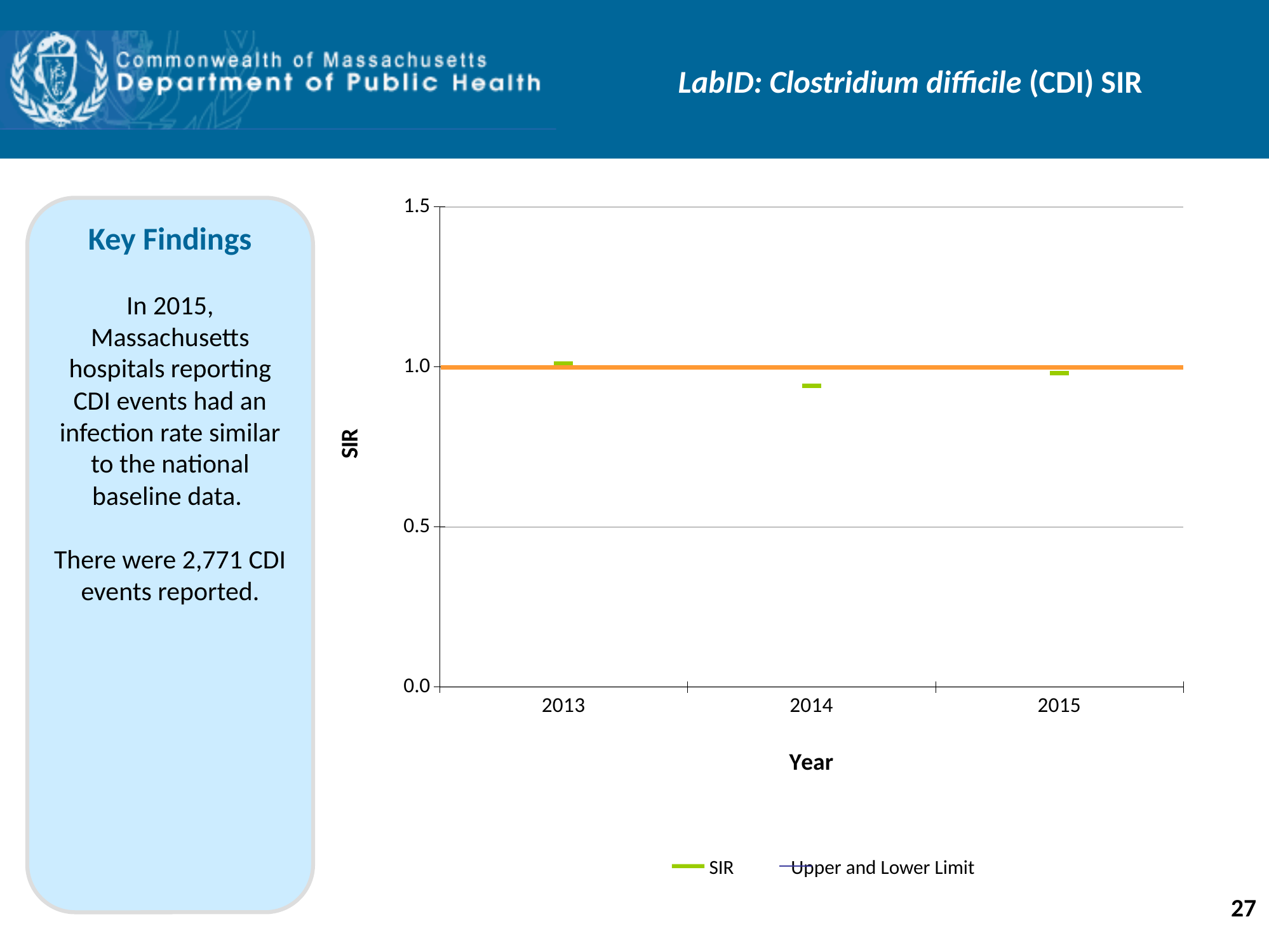
What is the title of the x axis of the chart? Year Is the SIR value for 2014 greater or less than 1.0? less Is the SIR value for 2014 greater or less than 0.5? greater What kind of chart is shown on the slide? line chart Does the SIR value rise or fall from 2013 to 2014? fall How many series does the chart legend list? 2 Is the SIR value for 2015 greater or less than 0.5? greater Which is larger, the SIR value for 2013 or for 2014? 2013 What are the two entries listed in the chart legend? SIR; Upper and Lower Limit Which year has the lowest SIR value in the chart? 2014 How many years are plotted on the x axis of the chart? 3